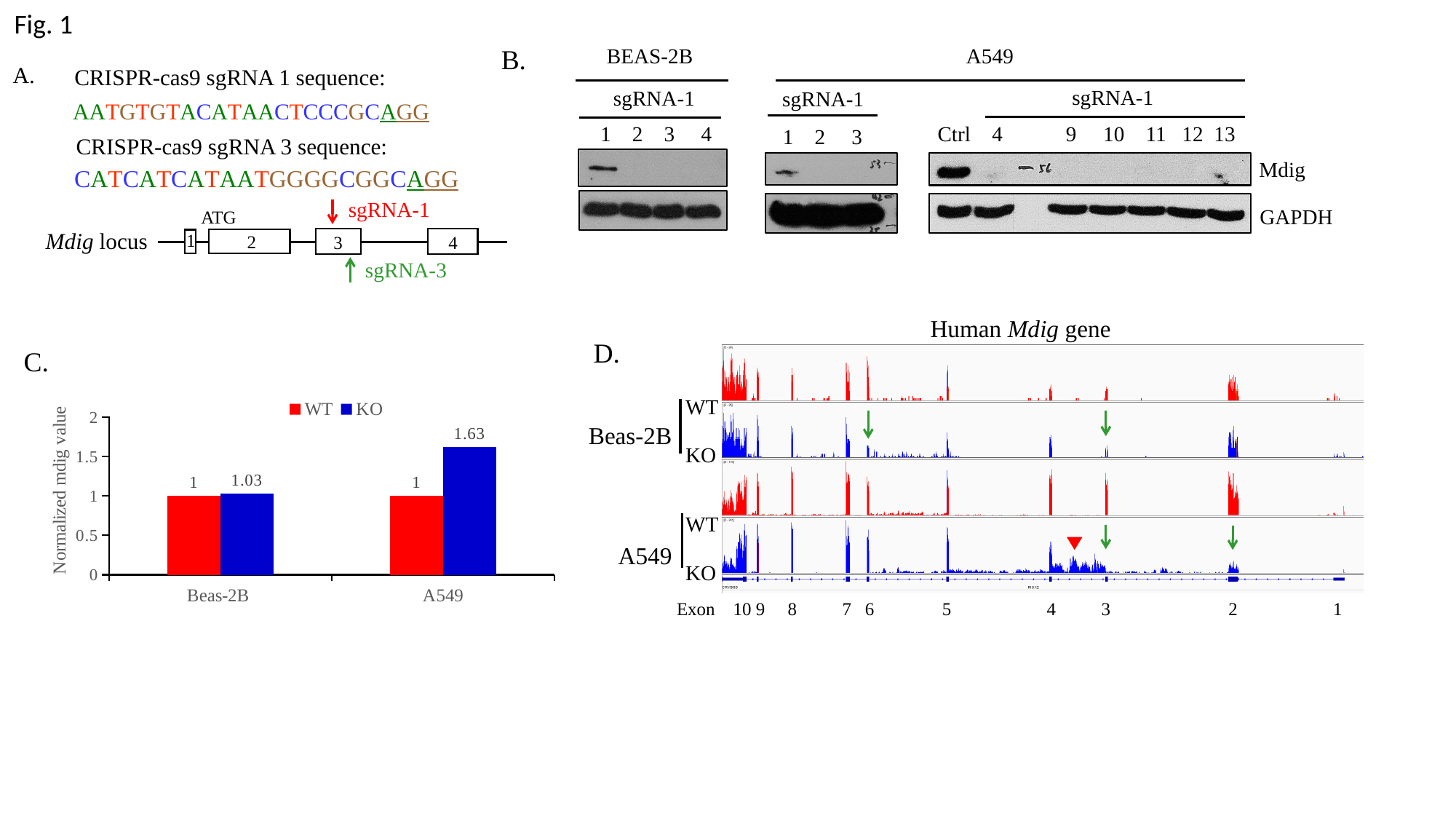
In the bar chart in panel C, is the KO value for A549 greater or less than 1.5? greater In the bar chart in panel C, what is the KO value for Beas-2B? 1.03 In the bar chart in panel C, what is the difference between the KO values for A549 and Beas-2B? 0.6 In the bar chart in panel C, what is the KO value for A549? 1.63 In the bar chart in panel C, which is larger, the KO value for A549 or the KO value for Beas-2B? A549 KO In the bar chart in panel C, how many series does the legend list? 2 In the bar chart in panel C, what colour represents the KO series? Blue In the bar chart in panel C, which bar is the highest? A549 KO In the bar chart in panel C, what is the WT value for A549? 1 In the bar chart in panel C, how many cell lines are shown on the x axis? 2 In the bar chart in panel C, what is the difference between the KO and WT values for A549? 0.63 What kind of chart is shown in panel C? Bar chart